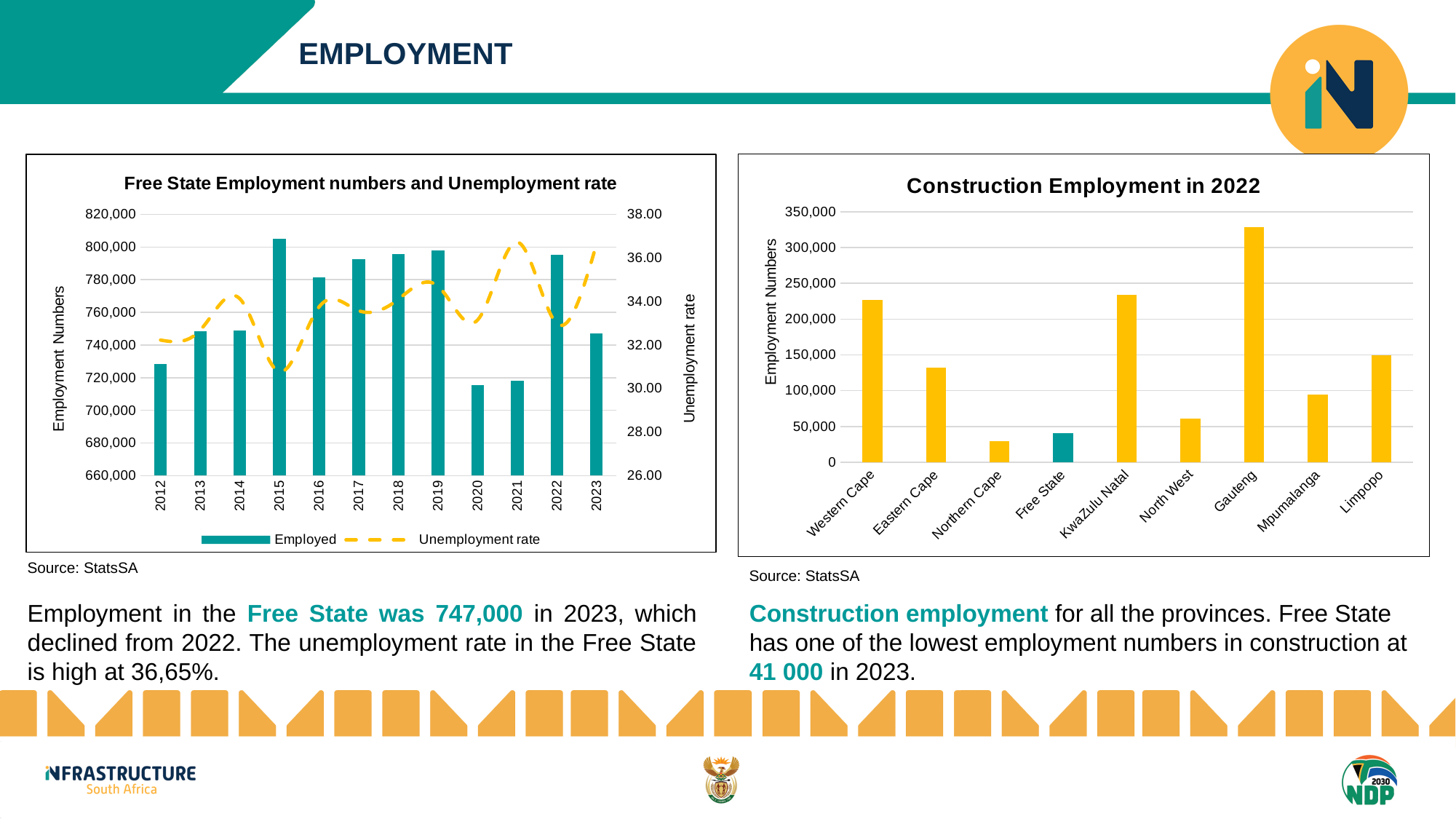
In the 'Free State Employment numbers and Unemployment rate' chart, is the number employed in 2012 greater or less than 740,000? less In the 'Construction Employment in 2022' chart, which has the larger value, Gauteng or KwaZulu Natal? Gauteng In the 'Construction Employment in 2022' chart, is the value for Mpumalanga greater or less than 100,000? less In the 'Construction Employment in 2022' chart, how many provinces are shown? 9 In the 'Free State Employment numbers and Unemployment rate' chart, how many years are shown on the x axis? 12 What kind of chart is the 'Construction Employment in 2022' chart? bar chart In the 'Construction Employment in 2022' chart, is the value for Western Cape greater or less than 200,000? greater In the 'Free State Employment numbers and Unemployment rate' chart, what are the two legend entries? Employed, Unemployment rate In the 'Construction Employment in 2022' chart, which province has the lowest construction employment? Northern Cape How many series does the legend of the 'Free State Employment numbers and Unemployment rate' chart list? 2 In the 'Free State Employment numbers and Unemployment rate' chart, which year has the highest number employed? 2015 In the 'Construction Employment in 2022' chart, which province has the highest construction employment? Gauteng